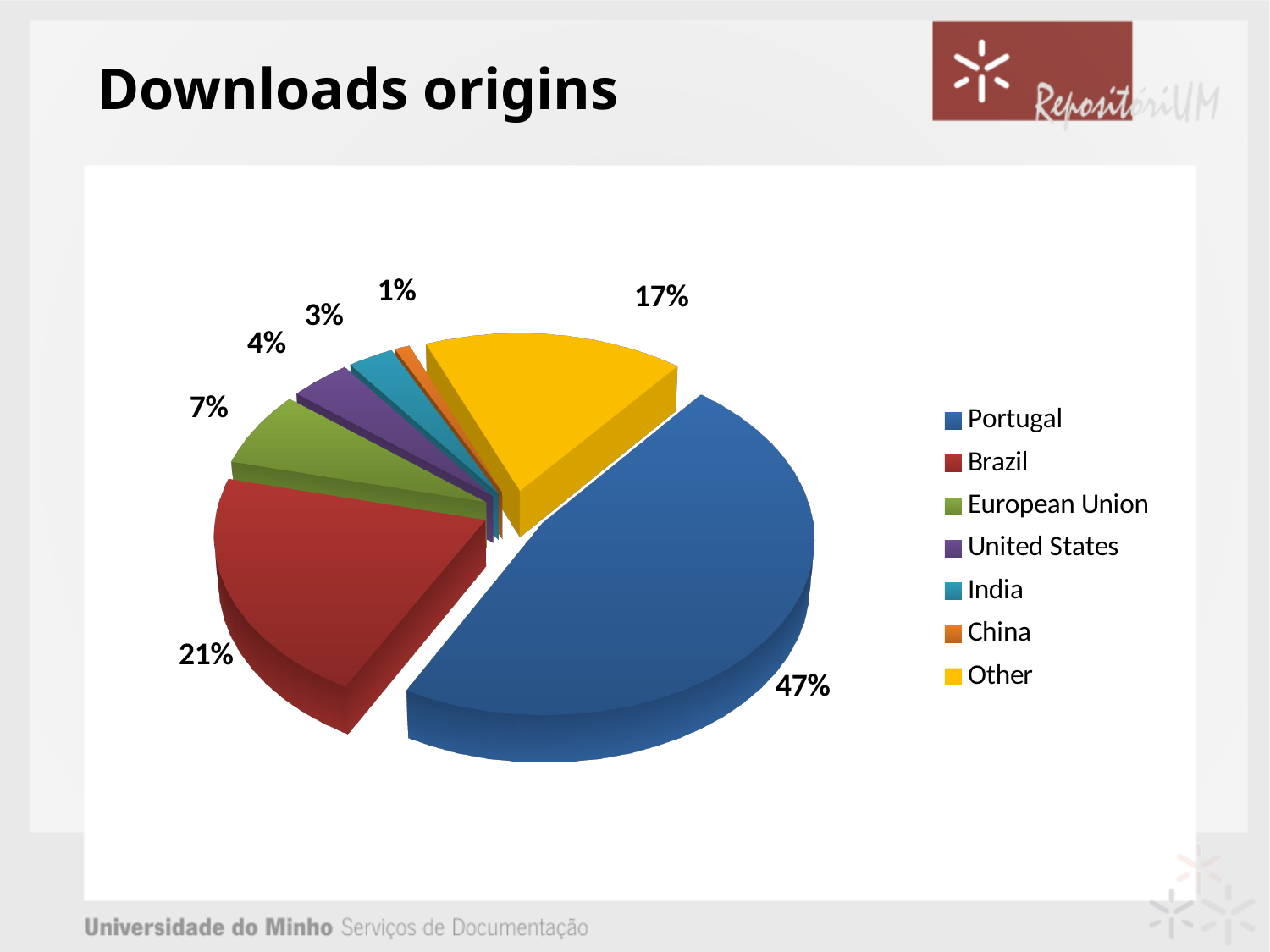
What colour is the slice for Other? Yellow What share of downloads comes from China? 1% What share of downloads comes from Brazil? 21% What share of downloads comes from the European Union? 7% What kind of chart is shown on the slide? Pie chart Which origin has the smallest share of downloads? China Which has a larger share of downloads, Brazil or Other? Brazil What is the difference in percentage points between the Portugal and Brazil shares? 26 How many categories does the pie chart show? 7 Which origin has the largest share of downloads? Portugal